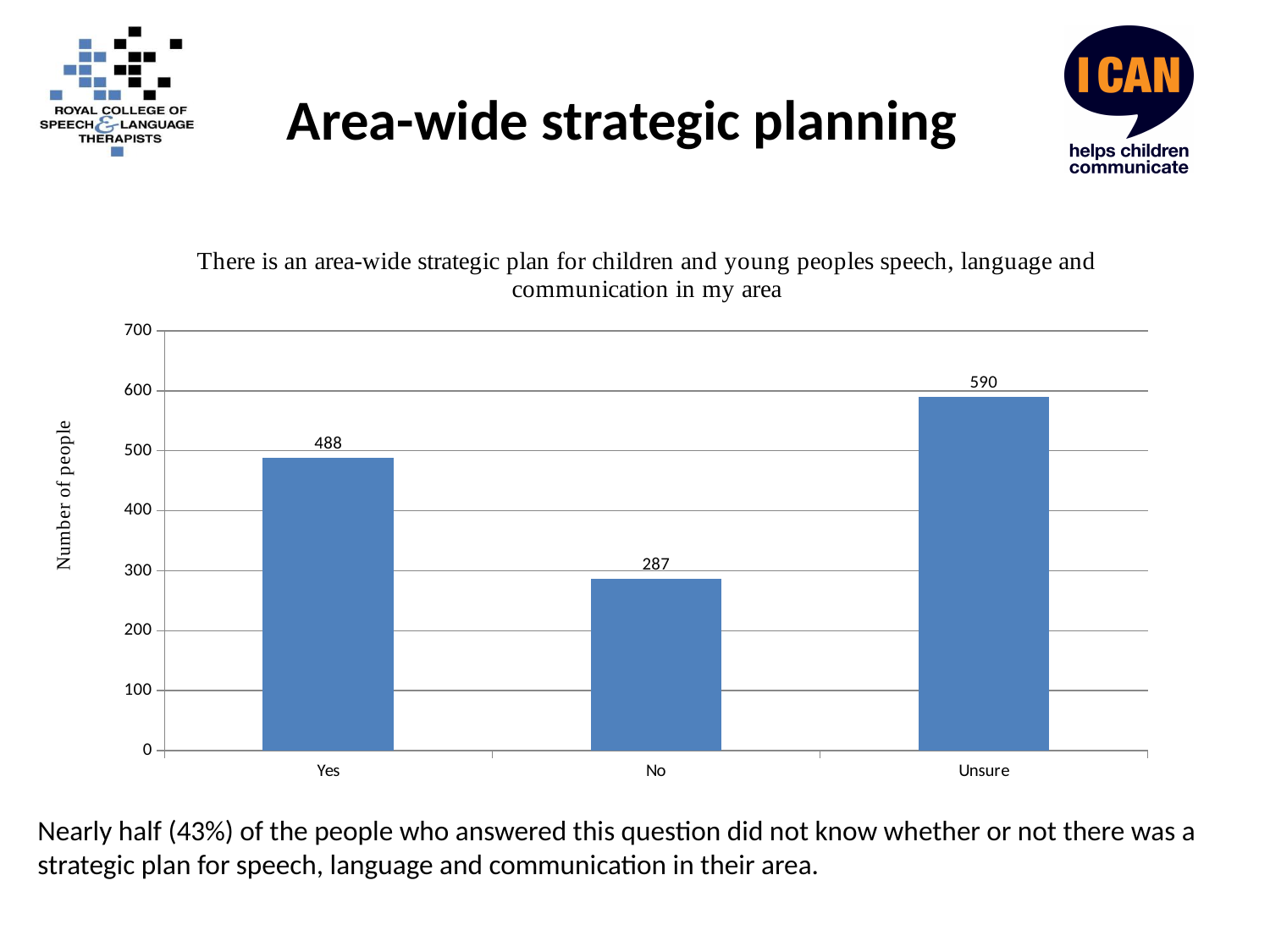
Which is larger, the value for Yes or the value for No? Yes Is the value for Unsure greater or less than 500? greater What is the number of people who answered Unsure? 590 What is the difference between the number of people who answered Yes and those who answered No? 201 Which response category has the highest number of people? Unsure How many response categories are shown on the x axis? 3 What is the number of people who answered Yes? 488 What is the label of the vertical axis? Number of people What is the number of people who answered No? 287 Which response category has the lowest number of people? No What is the difference between the number of people who answered Unsure and those who answered Yes? 102 What kind of chart is shown on the slide? bar chart